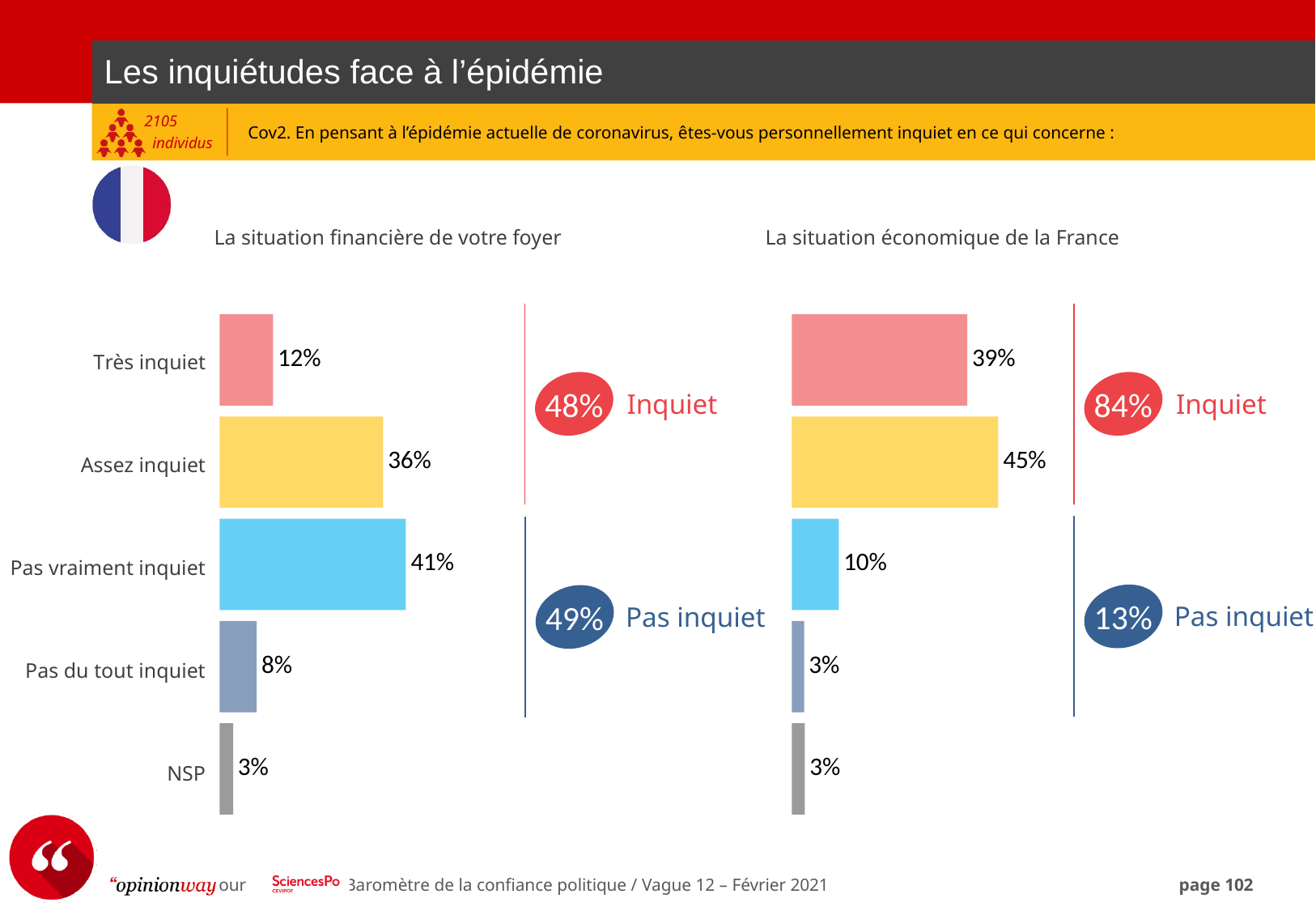
In the chart 'La situation financière de votre foyer', which category has the lowest value? NSP What kind of chart is 'La situation économique de la France'? Bar chart In the chart 'La situation financière de votre foyer', what is the value for 'Assez inquiet'? 36% In the chart 'La situation économique de la France', what combined share is labelled 'Inquiet'? 84% In the chart 'La situation économique de la France', what is the value for 'Pas vraiment inquiet'? 10% In the chart 'La situation économique de la France', what is the difference between 'Assez inquiet' and 'Très inquiet'? 6% In the chart 'La situation financière de votre foyer', which category has the highest value? Pas vraiment inquiet In the chart 'La situation financière de votre foyer', what is the difference between 'Pas vraiment inquiet' and 'Très inquiet'? 29% In the chart 'La situation économique de la France', which category has the highest value? Assez inquiet In the chart 'La situation économique de la France', what is the value for 'Très inquiet'? 39% Which is larger: 'Très inquiet' in the chart 'La situation financière de votre foyer' or 'Très inquiet' in the chart 'La situation économique de la France'? La situation économique de la France How many categories are shown in the chart 'La situation financière de votre foyer'? 5